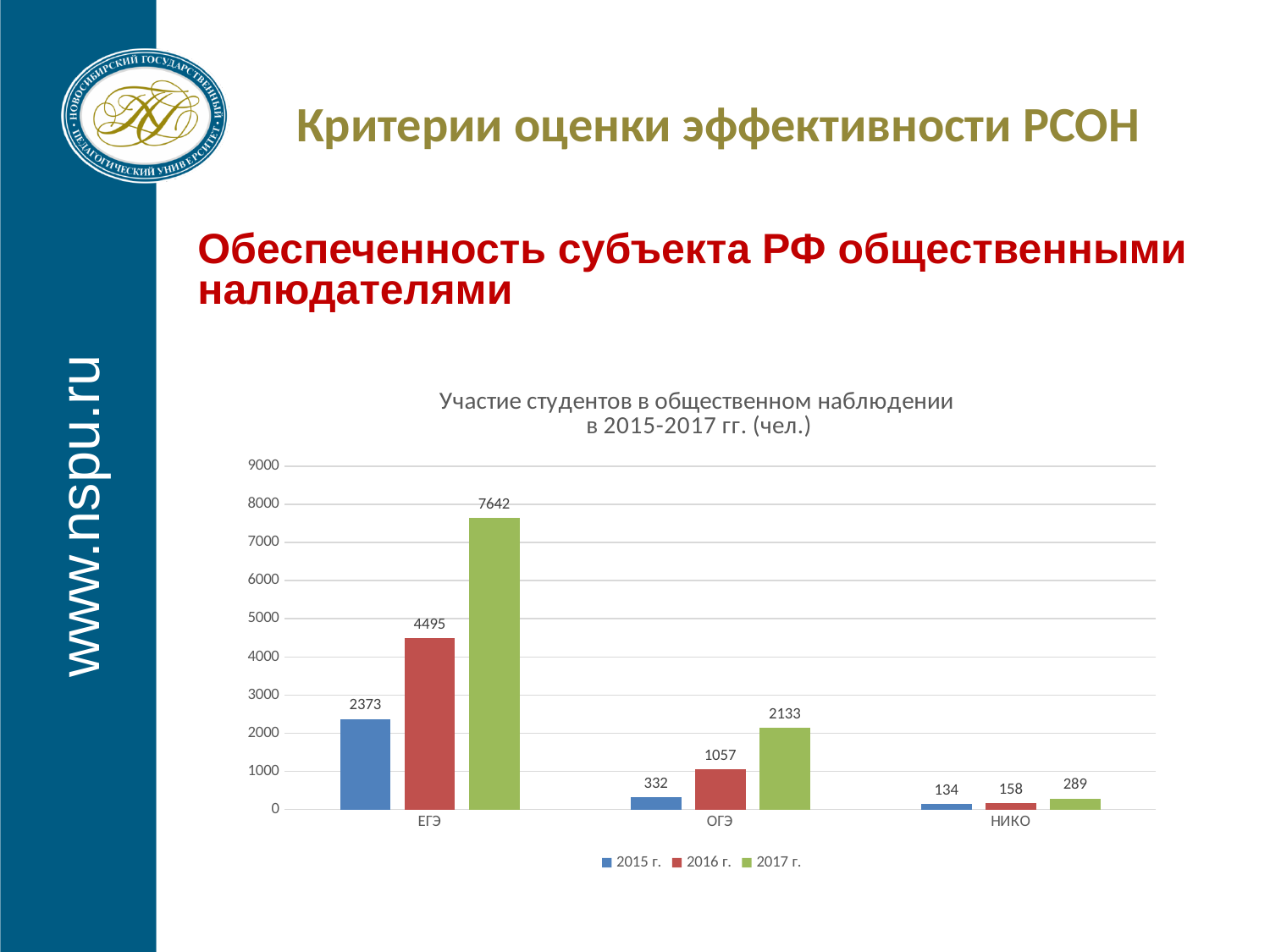
What is the value for НИКО in 2015 г.? 134 What is the value for ОГЭ in 2016 г.? 1057 Which category has the lowest value in 2015 г.? НИКО What is the title of the chart? Участие студентов в общественном наблюдении в 2015-2017 гг. (чел.) Which category has the highest value in 2017 г.? ЕГЭ How many series does the legend list? 3 Is the value for ЕГЭ in 2016 г. greater or less than 4000? greater Which is larger: the 2016 г. value for ОГЭ or the 2017 г. value for НИКО? 2016 г. value for ОГЭ What is the value for ЕГЭ in 2017 г.? 7642 What kind of chart is shown on the slide? bar chart How many categories are shown on the x axis? 3 What is the difference between the 2017 г. and 2016 г. values for ЕГЭ? 3147